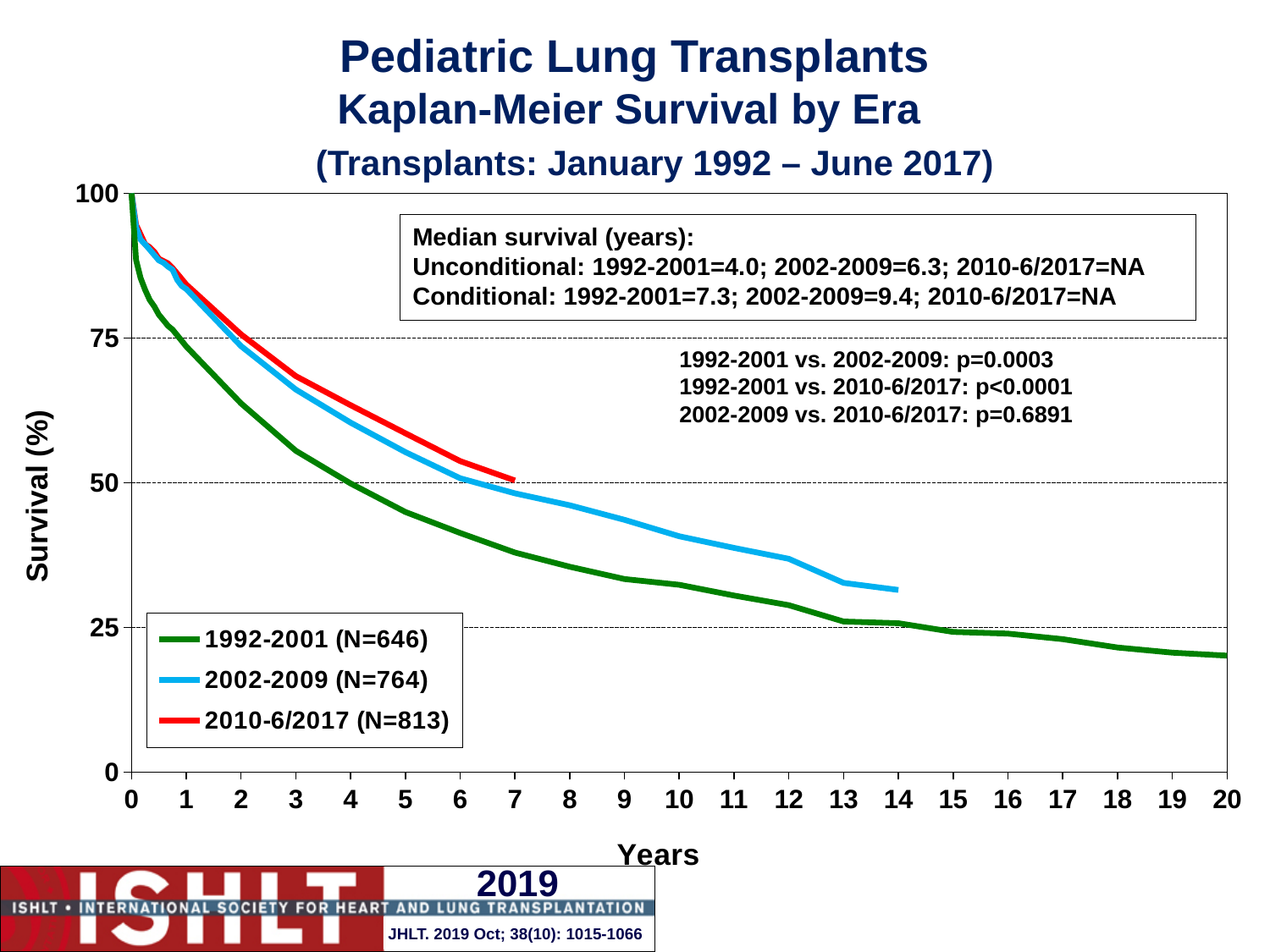
What is the p-value for the comparison of 1992-2001 vs. 2002-2009? p=0.0003 Is the survival for the 1992-2001 era at 10 years greater or less than 50%? less What is the number of patients (N) in the 2010-6/2017 era according to the legend? 813 What is the number of patients (N) in the 2002-2009 era according to the legend? 764 Is the survival for the 1992-2001 era at 20 years greater or less than 25%? less What is the unconditional median survival in years for the 2002-2009 era? 6.3 What is the conditional median survival in years for the 1992-2001 era? 7.3 At 5 years, which era has higher survival: 1992-2001 or 2010-6/2017? 2010-6/2017 What kind of chart is shown on the slide? line chart How many series (eras) does the legend list? 3 Do the survival curves rise or fall as years increase? fall Is the survival for the 2010-6/2017 era at 3 years greater or less than 50%? greater